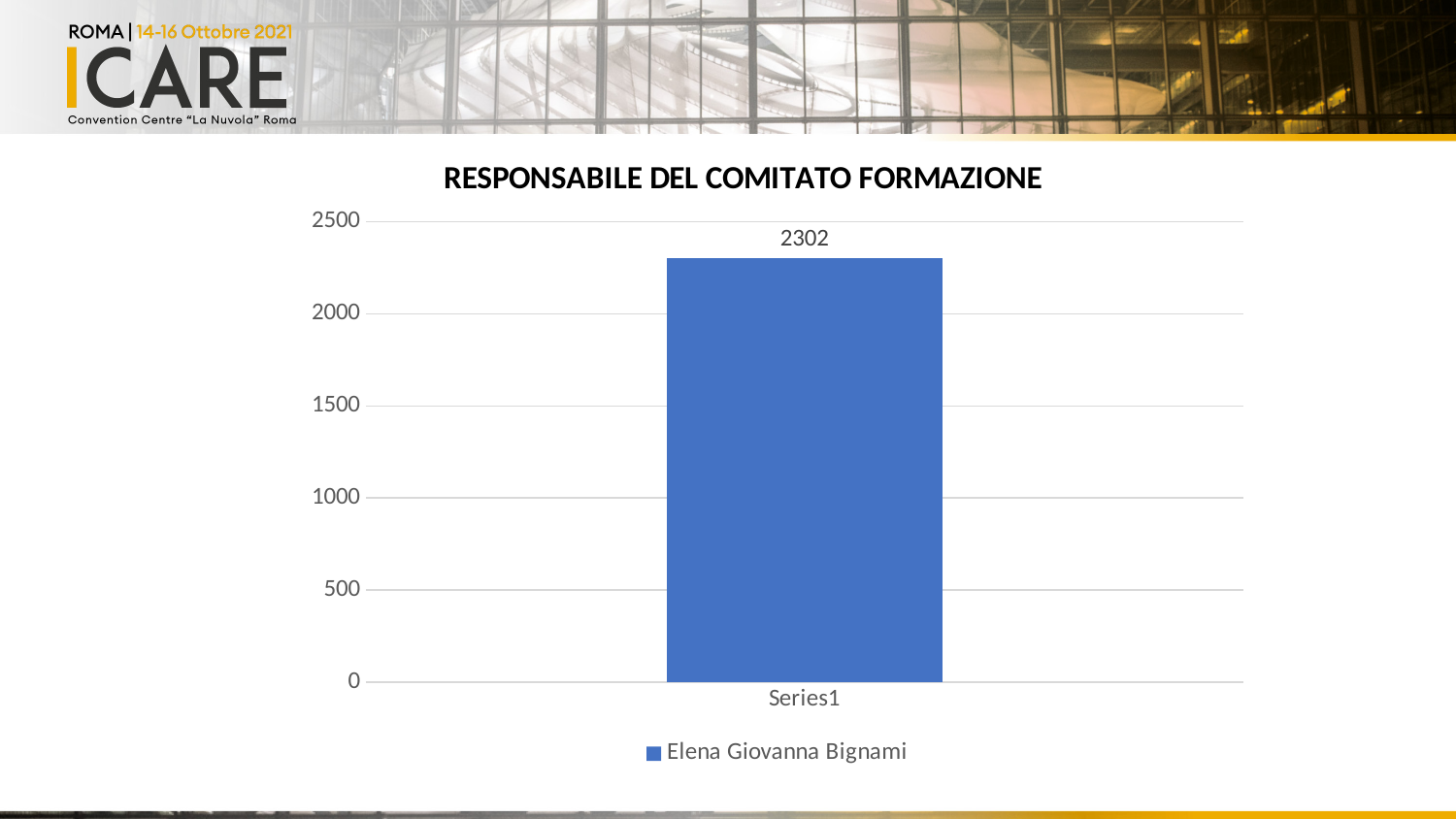
Is the value for Elena Giovanna Bignami greater or less than 2000? greater How many bars are plotted in the chart? 1 What is the value shown for Elena Giovanna Bignami in the chart? 2302 What label appears under the bar on the horizontal axis? Series1 What name appears in the chart legend? Elena Giovanna Bignami What is the highest value shown on the vertical axis? 2500 What kind of chart is shown on the slide? bar chart Is the value for Elena Giovanna Bignami greater or less than 2500? less How many series does the legend list? 1 What is the title of the chart? RESPONSABILE DEL COMITATO FORMAZIONE